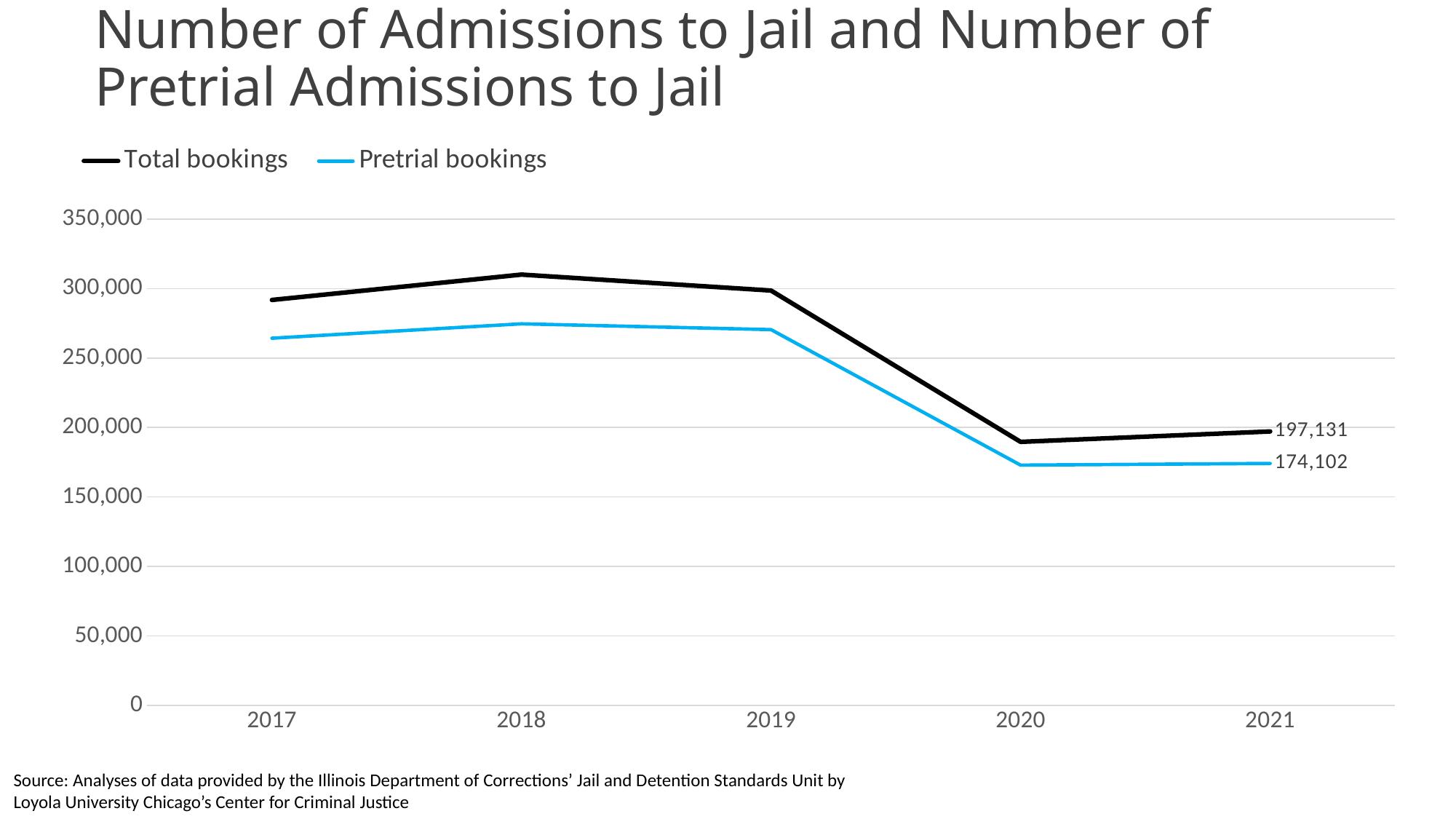
Is the value for Pretrial bookings in 2017 greater or less than 250,000? greater How many series does the legend list? 2 How many years are shown on the x axis? 5 What is the value for Pretrial bookings in 2021? 174,102 What kind of chart is shown on the slide? line chart What is the difference between Total bookings and Pretrial bookings in 2021? 23,029 Which year has the highest value for Total bookings? 2018 What is the value for Total bookings in 2021? 197,131 Which is larger in 2019, Total bookings or Pretrial bookings? Total bookings Which year has the lowest value for Total bookings? 2020 Is the value for Total bookings in 2018 greater or less than 300,000? greater